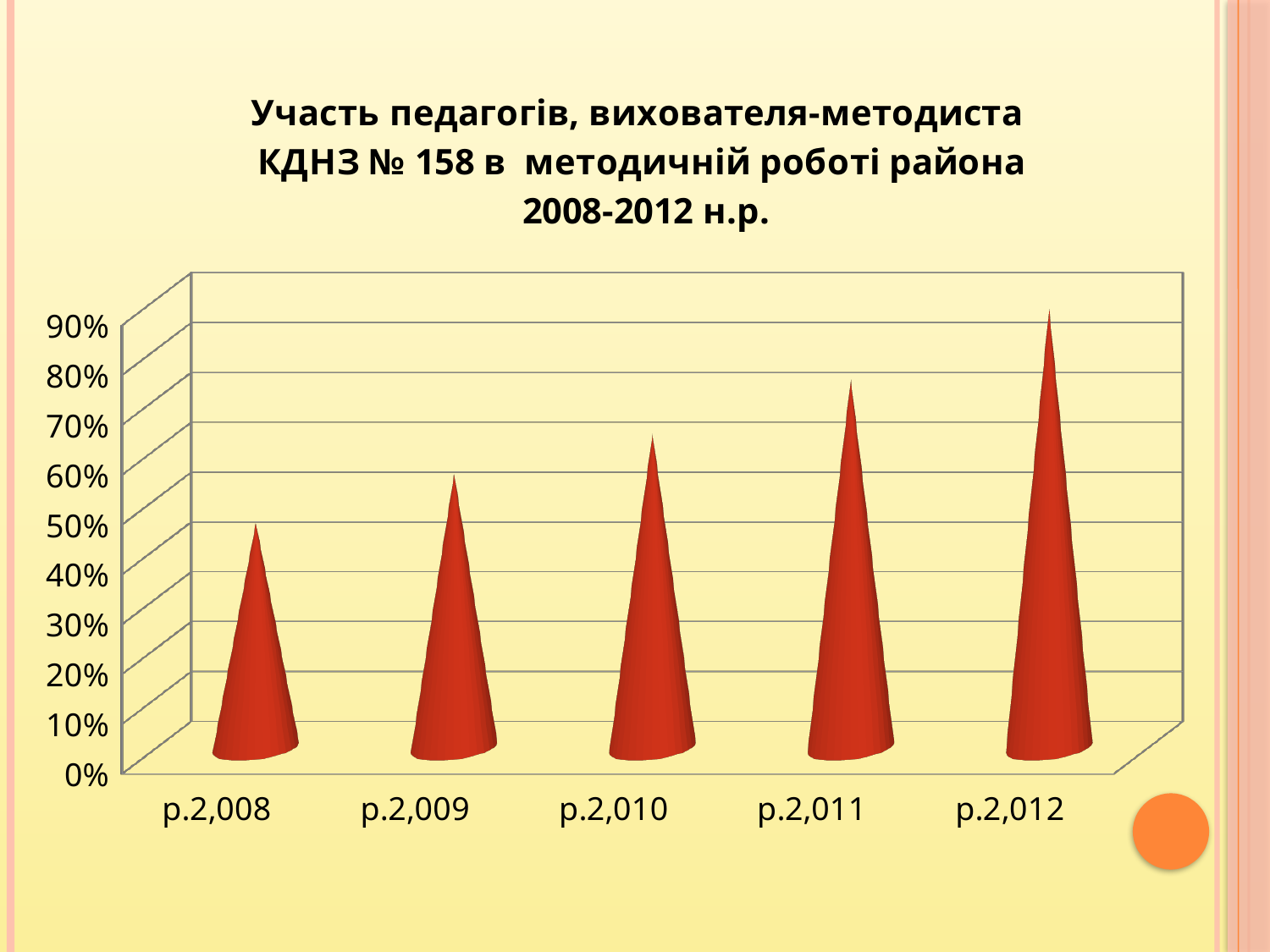
Which category has the lowest value in the chart? р.2,008 Which category has the highest value in the chart? р.2,012 Is the value for р.2,010 greater or less than 60%? greater Is the value for р.2,012 greater or less than 80%? greater Is the value for р.2,008 greater or less than 40%? greater Which is larger, the value for р.2,011 or the value for р.2,009? р.2,011 How many categories are shown on the x axis of the chart? 5 What colour are the bars in the chart? red What kind of chart is shown on the slide? bar chart Do the values rise or fall from р.2,008 to р.2,012? rise